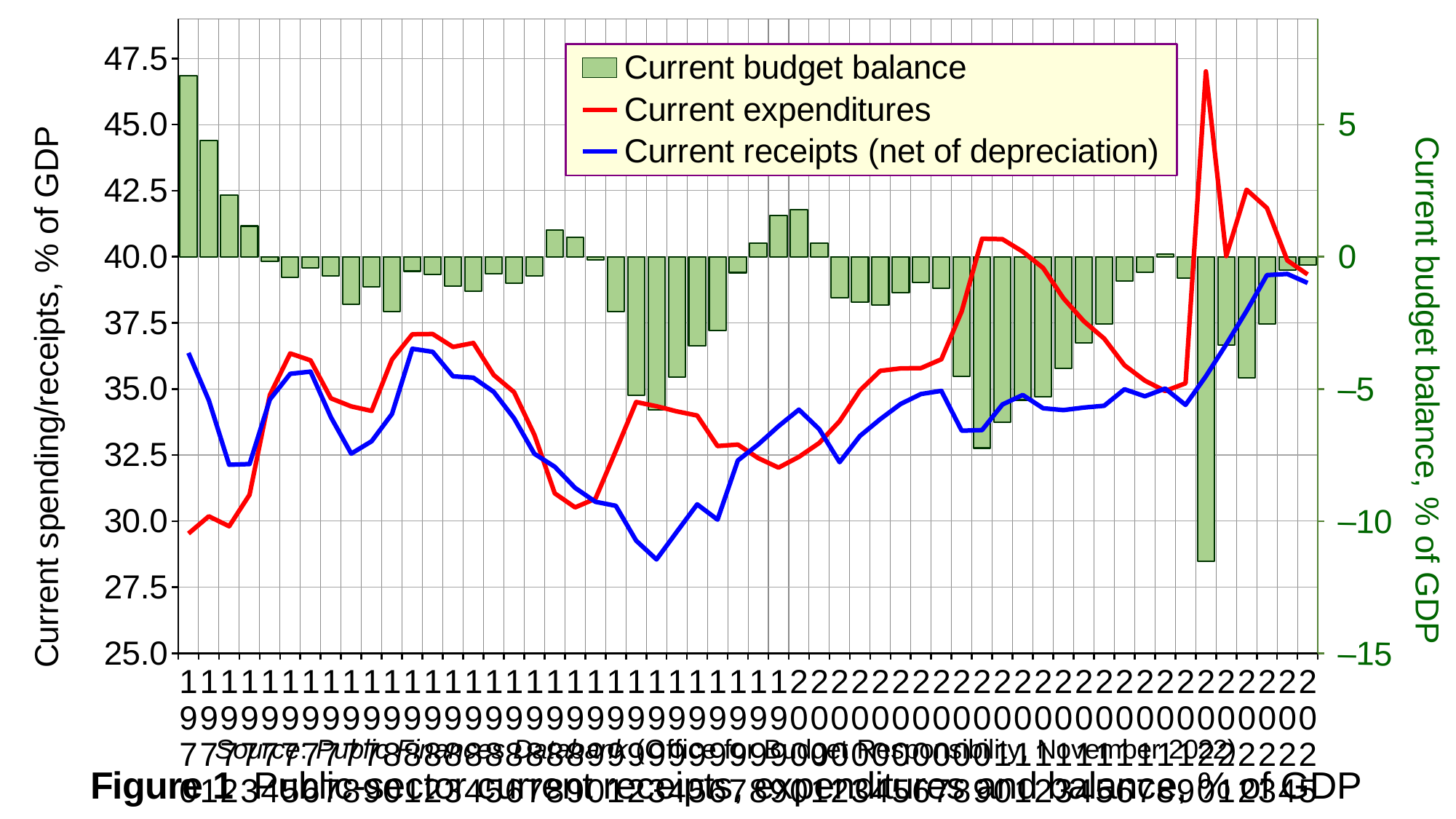
Which line reaches the highest value on the left axis, Current expenditures or Current receipts (net of depreciation)? Current expenditures Which line reaches the lowest value on the left axis, Current expenditures or Current receipts (net of depreciation)? Current receipts (net of depreciation) Overall, does the Current expenditures line rise or fall from the left end of the chart to the right end? rise Is the lowest Current budget balance bar greater or less than -10? less How many series does the legend list? 3 What is the label of the right-hand vertical axis? Current budget balance, % of GDP What kind of chart is this? A combined bar and line chart Which series is plotted as bars? Current budget balance Is the highest value reached by the Current expenditures line greater or less than 45? greater Is the tallest positive Current budget balance bar greater or less than 5? greater At the first year on the left of the chart, which is higher: Current expenditures or Current receipts (net of depreciation)? Current receipts (net of depreciation)